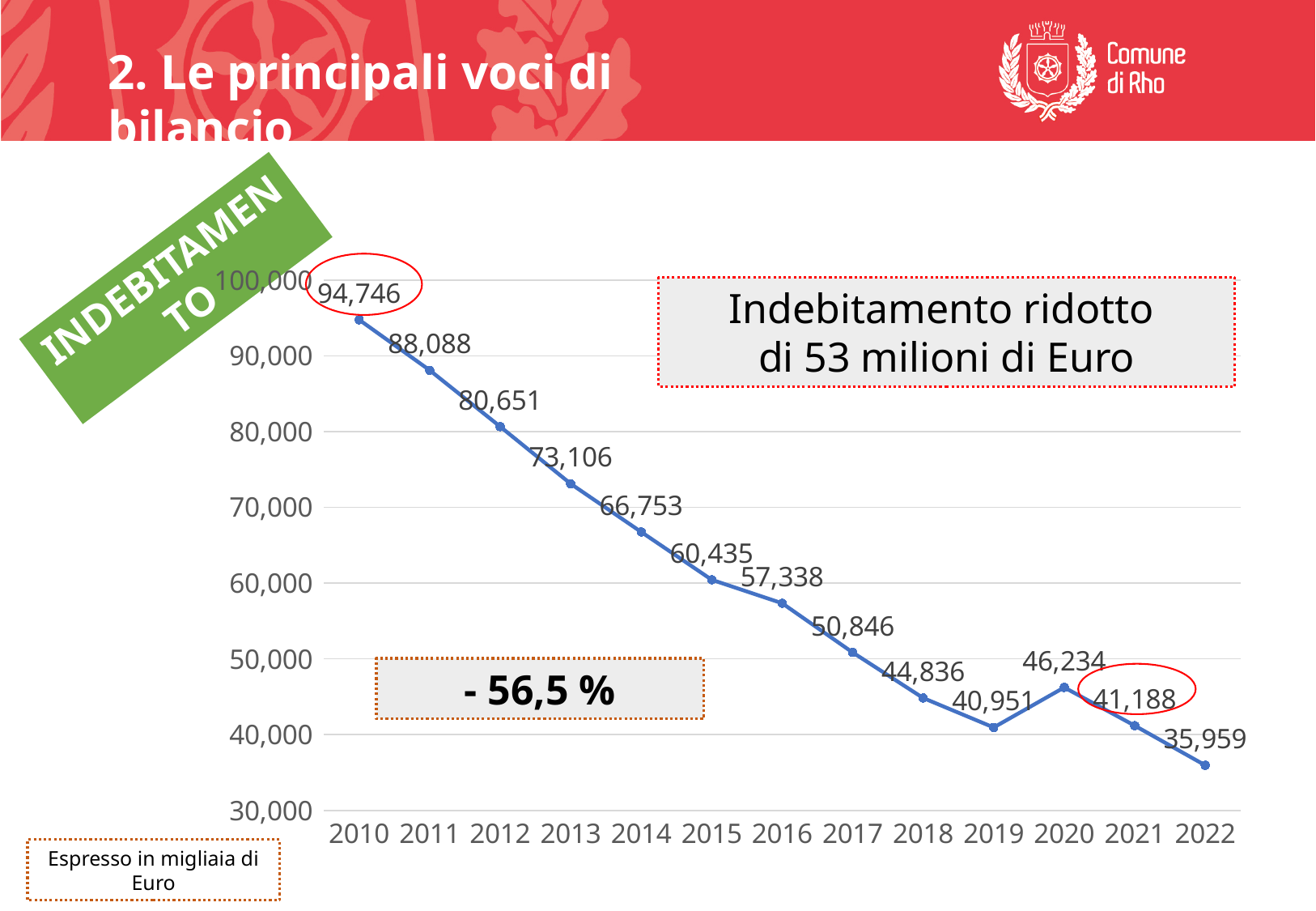
What is the value for 2016? 57,338 What kind of chart is shown? Line chart How many years are plotted on the x axis? 13 Which year has the highest value? 2010 Do the values generally rise or fall from 2010 to 2022? Fall What is the value for 2020? 46,234 What is the value for 2022? 35,959 What is the difference between the values for 2020 and 2019? 5,283 Which is larger, the value for 2019 or the value for 2021? 2021 Which year has the lowest value? 2022 What is the difference between the values for 2010 and 2022? 58,787 What is the value for 2010? 94,746